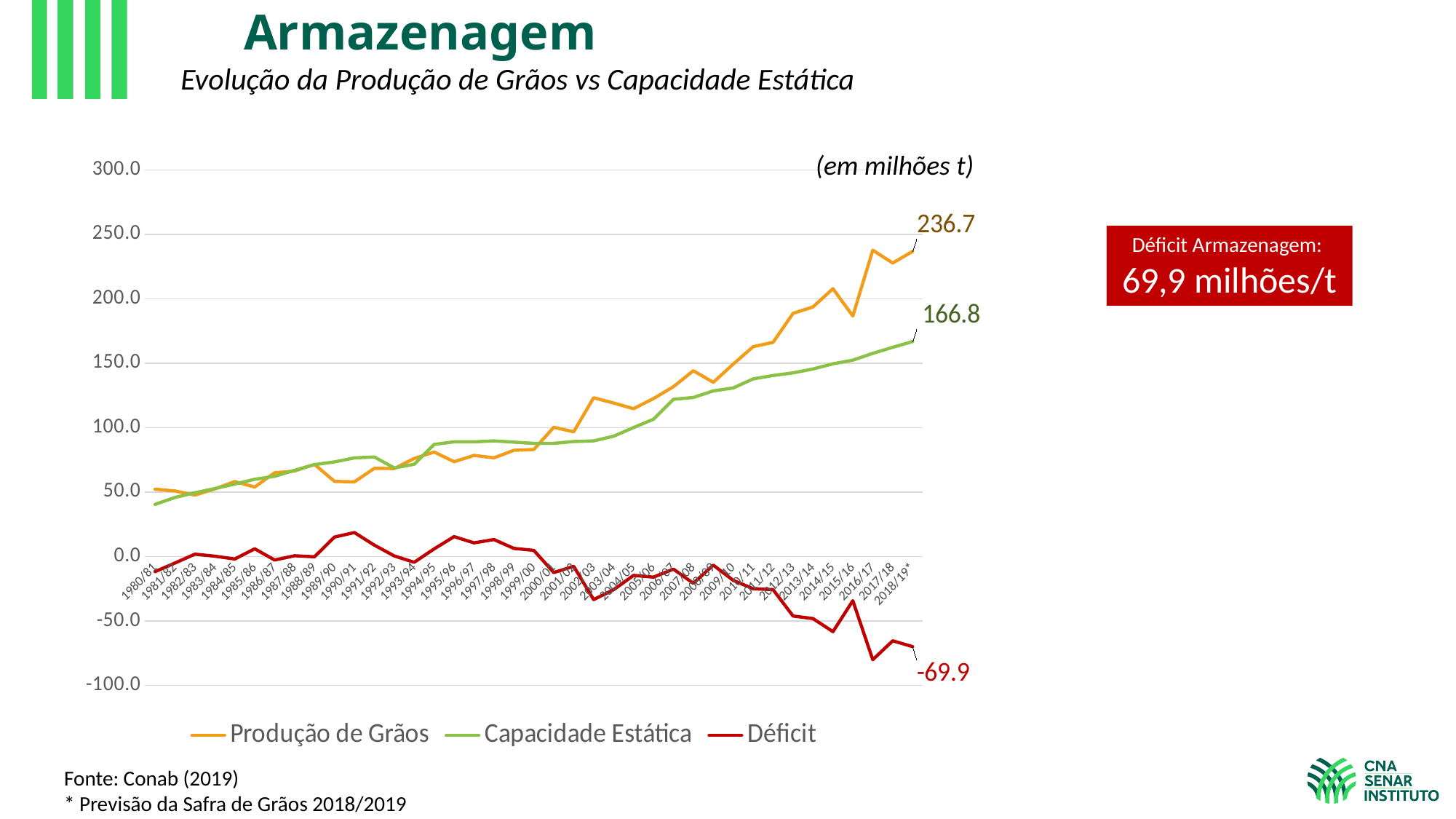
Is the value of Capacidade Estática for 1980/81 greater or less than 50.0? less What is the difference between Produção de Grãos and Capacidade Estática in 2018/19*? 69.9 How many harvest years are plotted on the x axis? 39 What is the value of Déficit for 2018/19*? -69.9 Does the Produção de Grãos line generally rise or fall from 1980/81 to 2018/19*? rise What kind of chart is shown on the slide? line chart In 2018/19*, which is larger: Produção de Grãos or Capacidade Estática? Produção de Grãos What is the value of Capacidade Estática for 2018/19*? 166.8 Is the value of Produção de Grãos for 2015/16 greater or less than 200.0? less How many series does the legend list? 3 What is the value of Produção de Grãos for 2018/19*? 236.7 What unit is indicated for the values in the chart? em milhões t